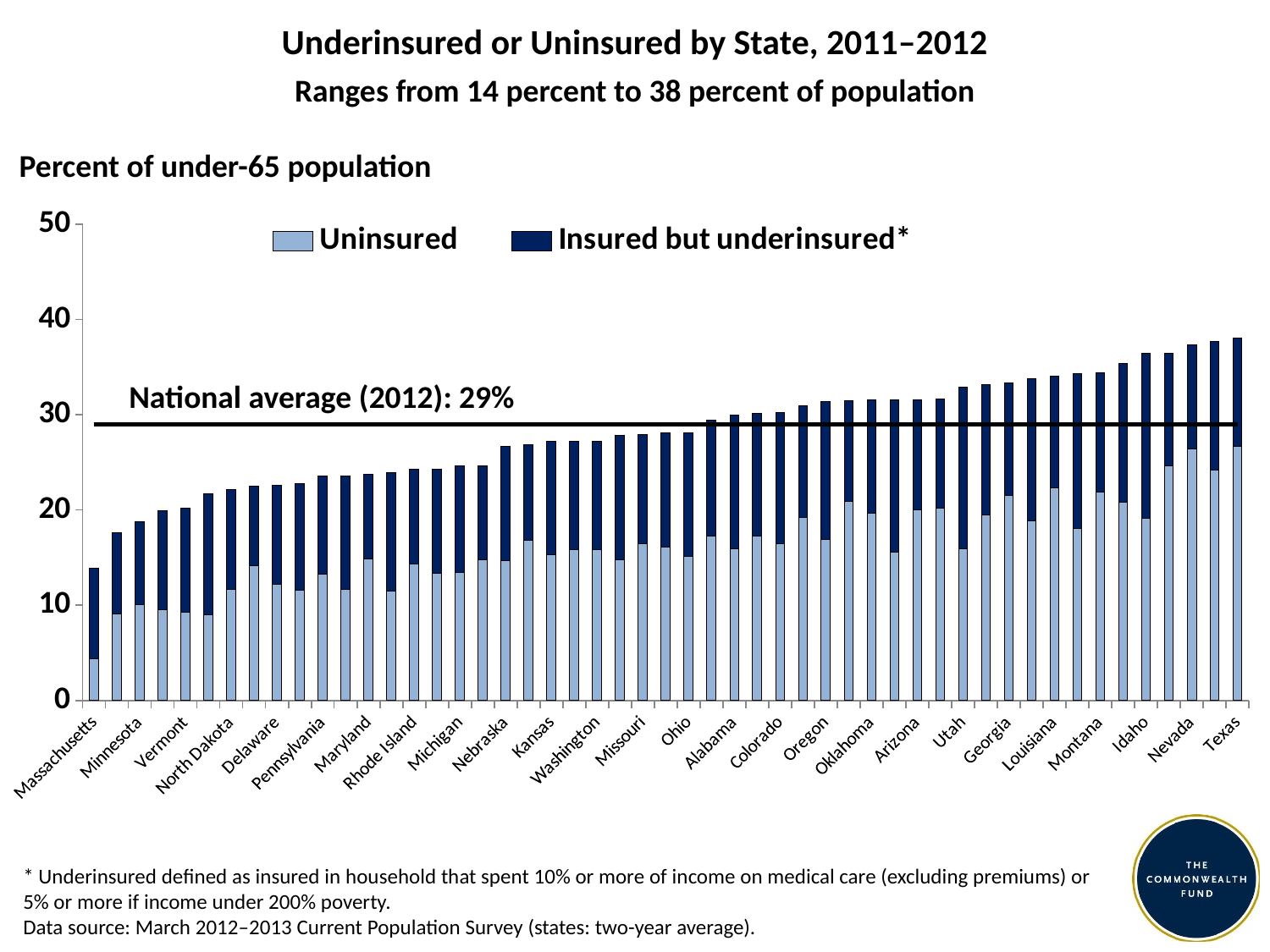
How many series does the legend list? 2 Which state has a larger total bar, Nevada or Minnesota? Nevada What is the national average (2012) shown by the horizontal line? 29% What kind of chart is shown on the slide? Stacked bar chart Which state has the highest total underinsured or uninsured percentage? Texas Is the total value for Ohio greater or less than 30? less Is the total value for Massachusetts greater or less than 20? less What are the two legend entries in the chart? Uninsured; Insured but underinsured* Do the total bar heights rise or fall moving from left to right along the x axis? Rise Which state has the lowest total underinsured or uninsured percentage? Massachusetts Is the Uninsured value for Massachusetts greater or less than 10? less